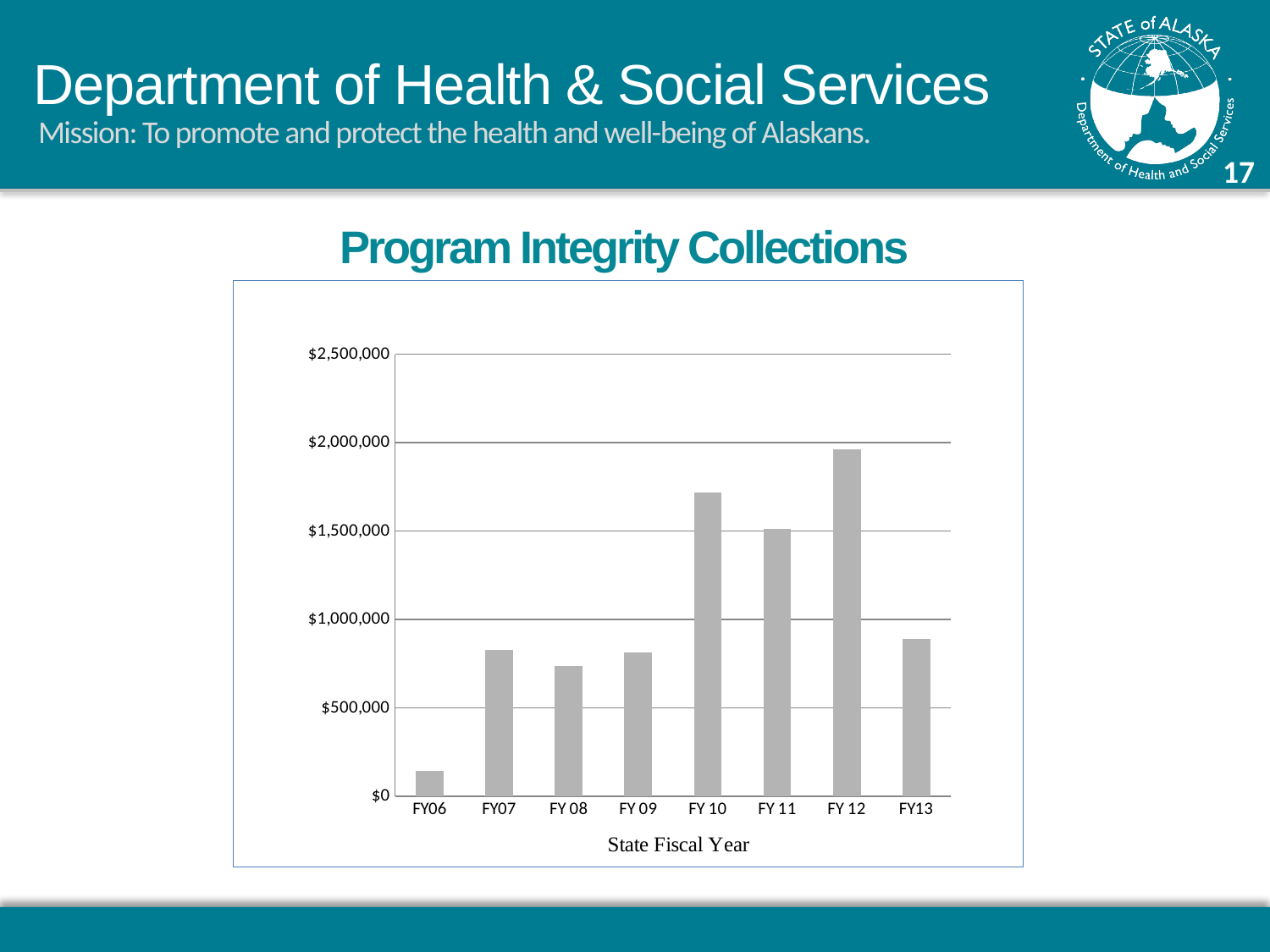
How many fiscal years are plotted on the chart? 8 Is the value for FY06 greater or less than $500,000? less Which fiscal year has the lowest collections? FY06 Which is larger, the value for FY 10 or the value for FY 11? FY 10 Do collections rise or fall from FY 12 to FY13? fall Is the value for FY 10 greater or less than $1,500,000? greater Is the value for FY13 greater or less than $1,000,000? less Which fiscal year has the highest collections? FY 12 What is the title of the chart? Program Integrity Collections What is the label on the x axis of the chart? State Fiscal Year What kind of chart is shown on the slide? Bar chart